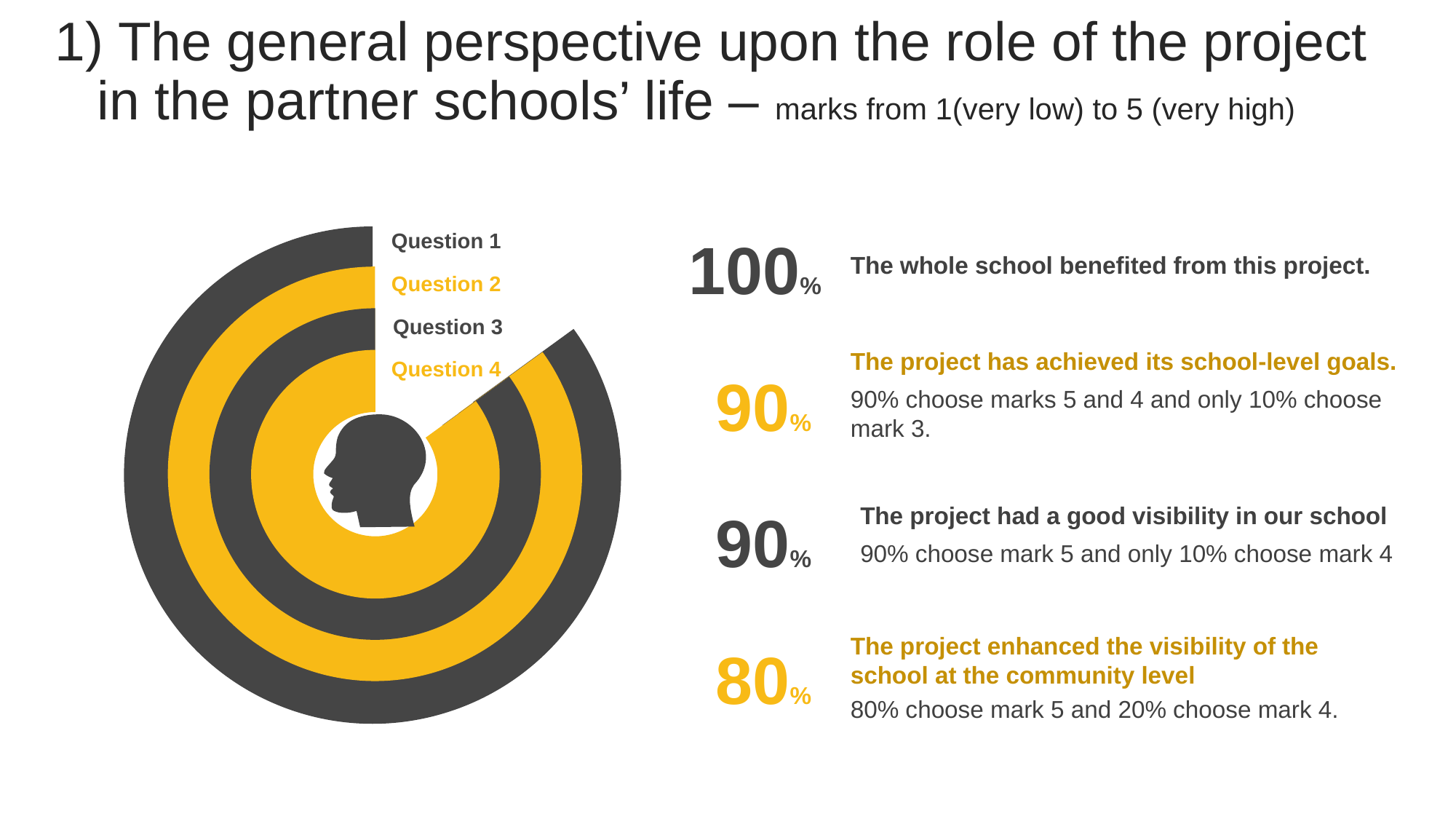
What percentage is shown for the statement 'The project had a good visibility in our school'? 90% What is the difference between the highest percentage (100%) and the lowest percentage (80%)? 20% Which is larger, the percentage for Question 1 or the percentage for Question 4? Question 1 What percentage is shown for the statement 'The whole school benefited from this project'? 100% What colour is the outermost ring (Question 1)? dark grey What kind of chart is shown on the slide? doughnut chart What colour is the ring for Question 2? yellow How many questions (rings) does the chart show? 4 Which question has the lowest percentage? Question 4 What percentage is shown for the statement 'The project has achieved its school-level goals'? 90% What percentage is shown for the statement 'The project enhanced the visibility of the school at the community level'? 80% Which question has the highest percentage? Question 1